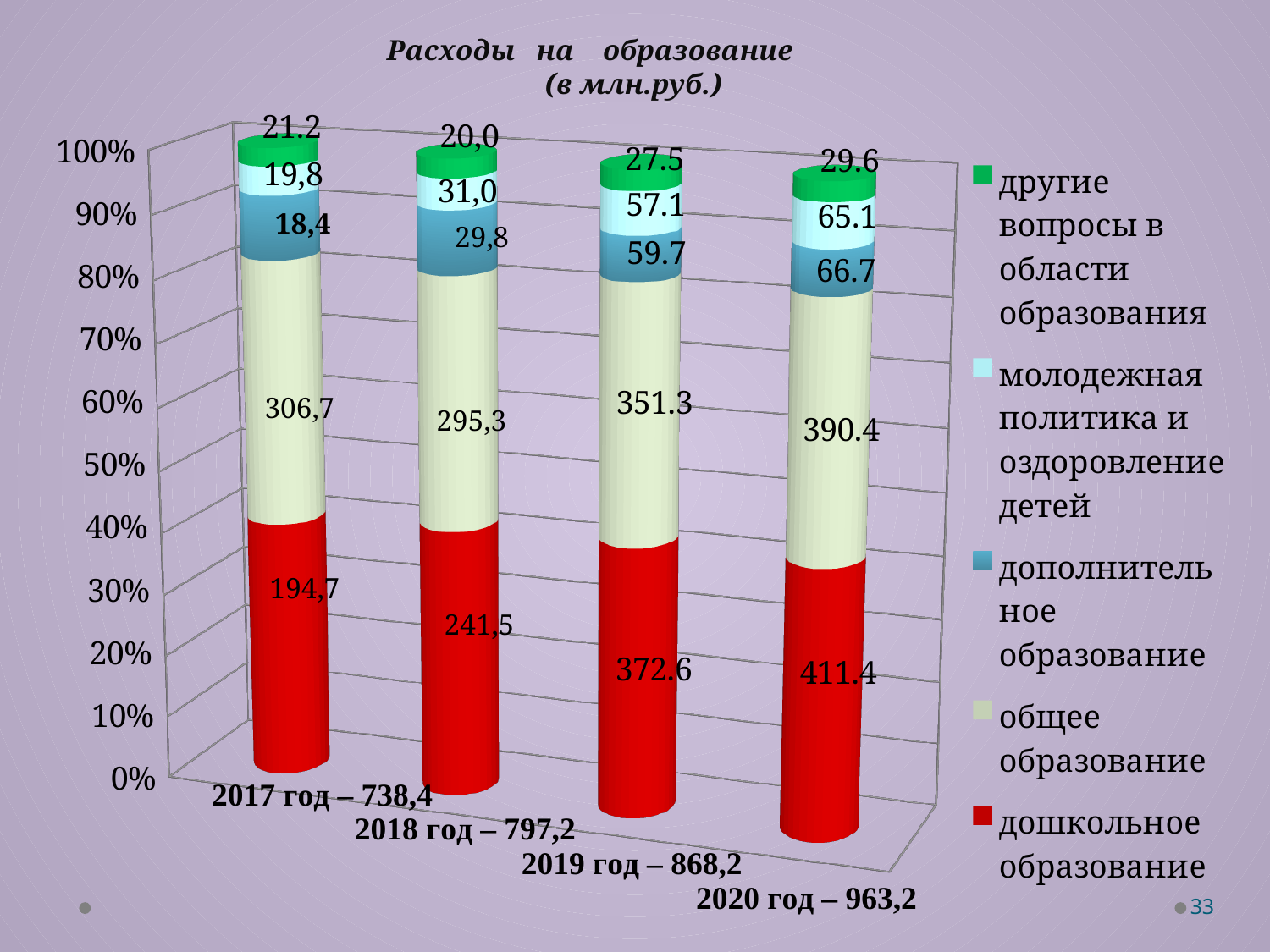
Which year has the lowest value for дополнительное образование? 2017 год How many years are shown on the x axis? 4 Which year has the highest value for дошкольное образование? 2020 год What kind of chart is shown on the slide? Stacked bar chart What is the value for молодежная политика и оздоровление детей in 2018 год? 31,0 What is the total for 2019 год as printed on the slide? 868,2 What is the difference between the дошкольное образование values for 2020 год and 2019 год? 38.8 How many series does the legend list? 5 What is the value for дошкольное образование in 2017 год? 194,7 Which is larger in 2018 год: дошкольное образование or общее образование? общее образование What is the value for дополнительное образование in 2019 год? 59.7 What is the value for общее образование in 2020 год? 390.4